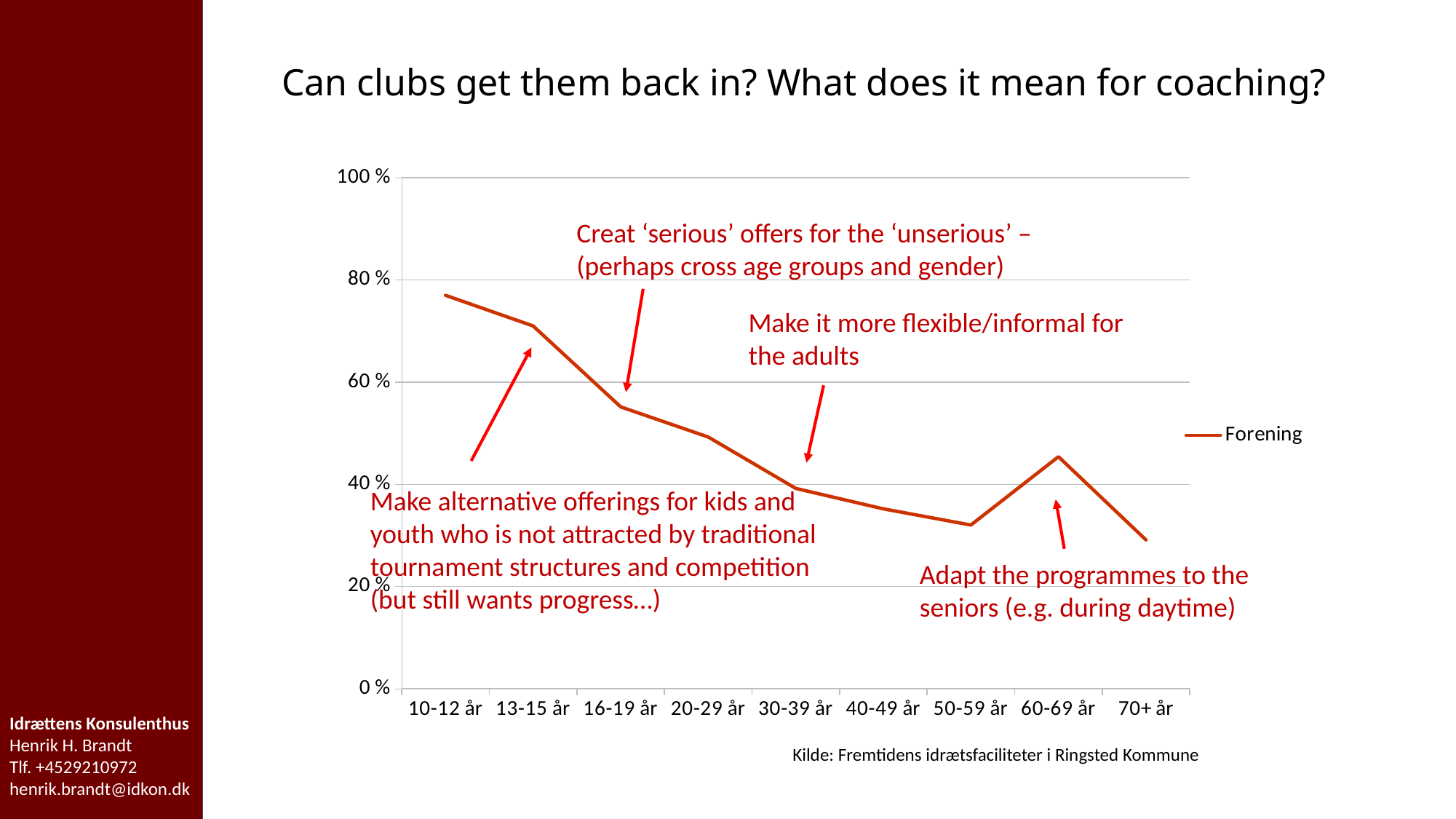
Is the value for 40-49 år greater or less than 40 %? less Does the Forening line generally rise or fall from 10-12 år to 50-59 år? fall How many age-group categories are plotted along the x axis? 9 Is the value for 60-69 år greater or less than 40 %? greater What kind of chart is shown on the slide? line chart What is the name of the series shown in the legend? Forening Is the value for 10-12 år greater or less than 60 %? greater Which has the larger value, 50-59 år or 60-69 år? 60-69 år Which age group has the highest value for Forening? 10-12 år Which has the larger value, 13-15 år or 16-19 år? 13-15 år How many series does the legend list? 1